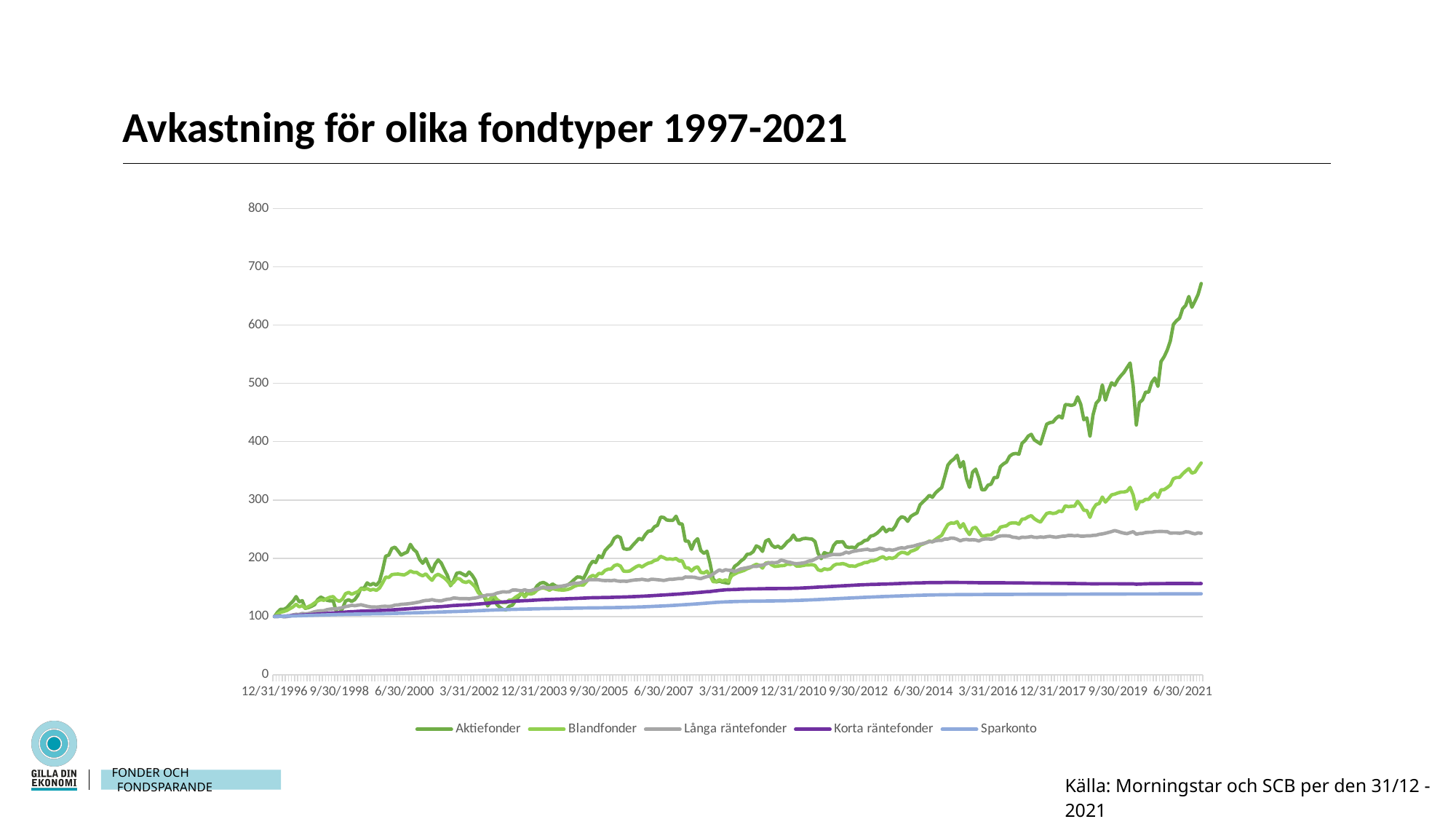
Is the value for Blandfonder at the end of the period greater or less than 300? greater Which series has the highest value at the end of the period (6/30/2021 onward)? Aktiefonder Does the Sparkonto series rise or fall over the period from 12/31/1996 to 2021? rise Is the value for Aktiefonder at the end of the period greater or less than 600? greater How many series does the legend list? 5 Which series has the lowest value at the end of the period? Sparkonto What kind of chart is shown on the slide? line chart Is the value for Långa räntefonder at the end of the period greater or less than 300? less What is the title of the chart? Avkastning för olika fondtyper 1997-2021 What is the highest value shown on the y axis? 800 At the end of the period, which is higher: Blandfonder or Långa räntefonder? Blandfonder